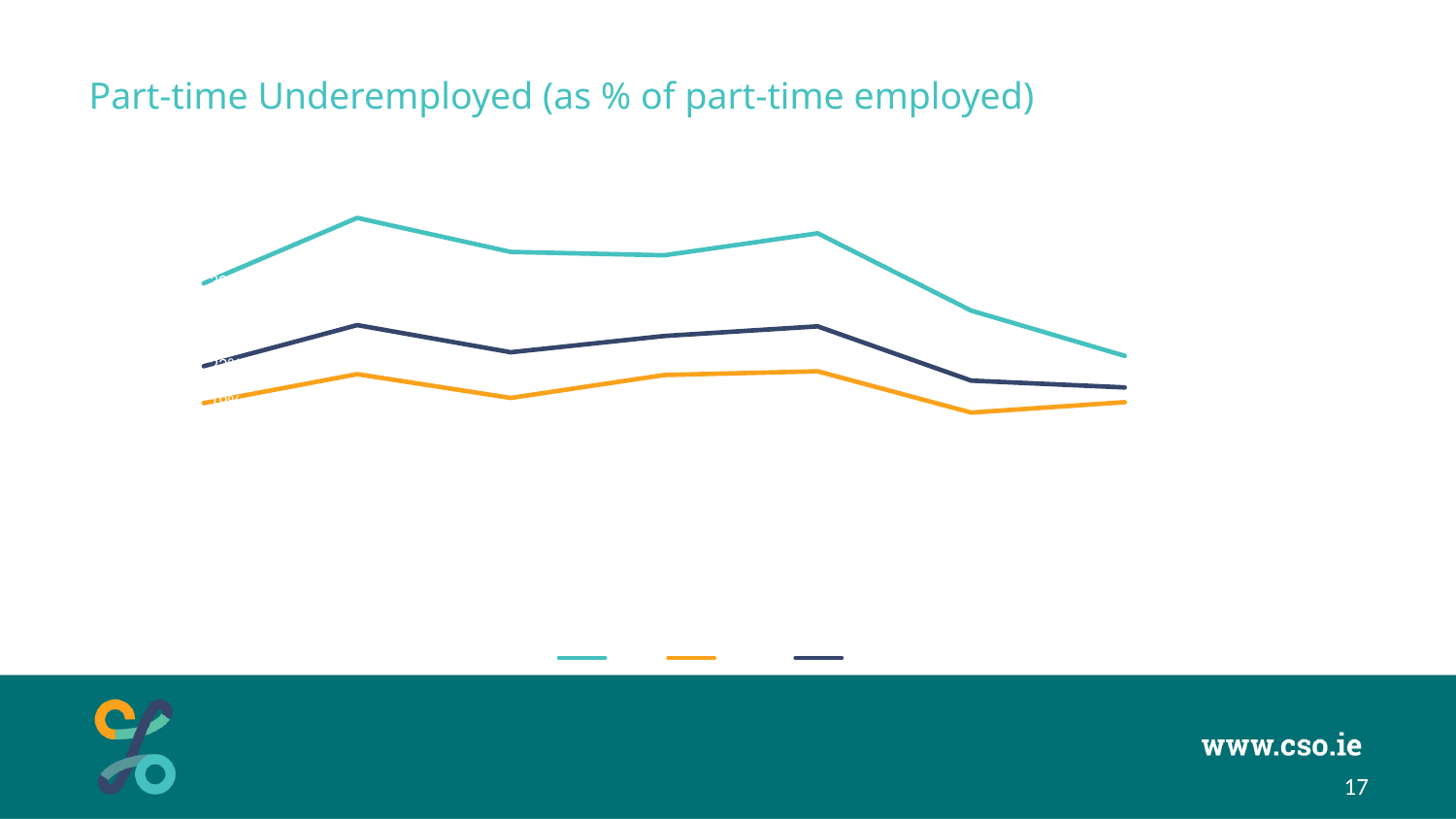
What is the title of the chart? Part-time Underemployed (as % of part-time employed) Does the teal line rise or fall over its last three points? fall Does the orange line rise or fall between its sixth and seventh points? rise Does the teal line rise or fall between its first and second points? rise What colours are the three lines in the chart? teal, orange and dark navy Which coloured line is the lowest across the whole chart? the orange line Which coloured line is the highest across the whole chart? the teal line How many data points does each line in the chart have? 7 How many series does the legend list? 3 At the last point on the x axis, is the teal line above or below the dark navy line? above What kind of chart is shown on the slide? line chart